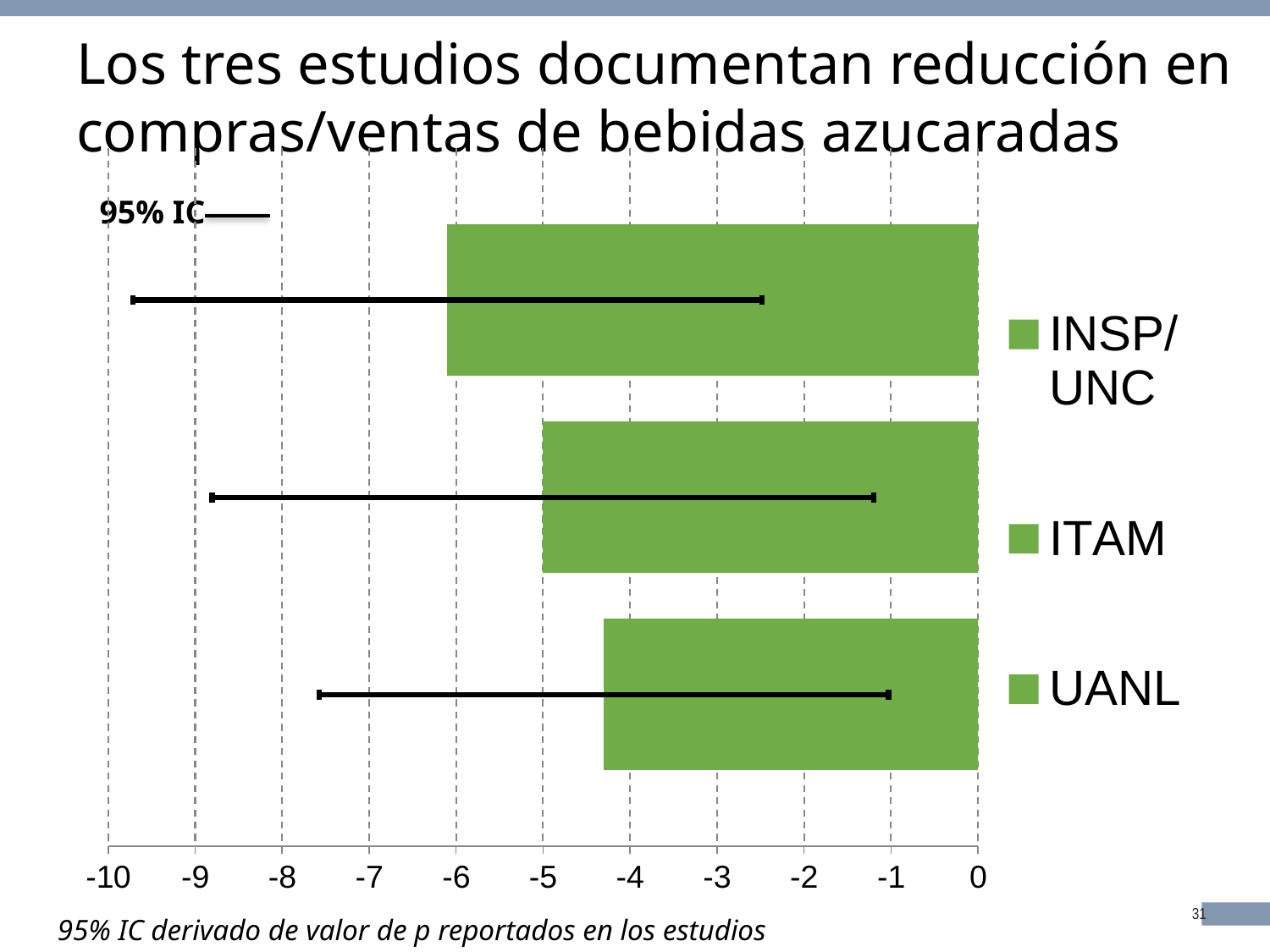
What kind of chart is shown on the slide? bar chart Which has the more negative value, INSP/UNC or ITAM? INSP/UNC Which category has the most negative value (the longest bar)? INSP/UNC What do the black horizontal lines drawn across the bars represent, according to the chart's key? 95% IC How many bars are plotted in the chart? 3 How many entries does the chart legend list? 3 Is the value for UANL greater or less than -5? greater Is the value for INSP/UNC greater or less than -5? less What is the lowest value shown on the horizontal axis? -10 Is the value for ITAM greater or less than -7? greater Which category has the value closest to zero (the shortest bar)? UANL